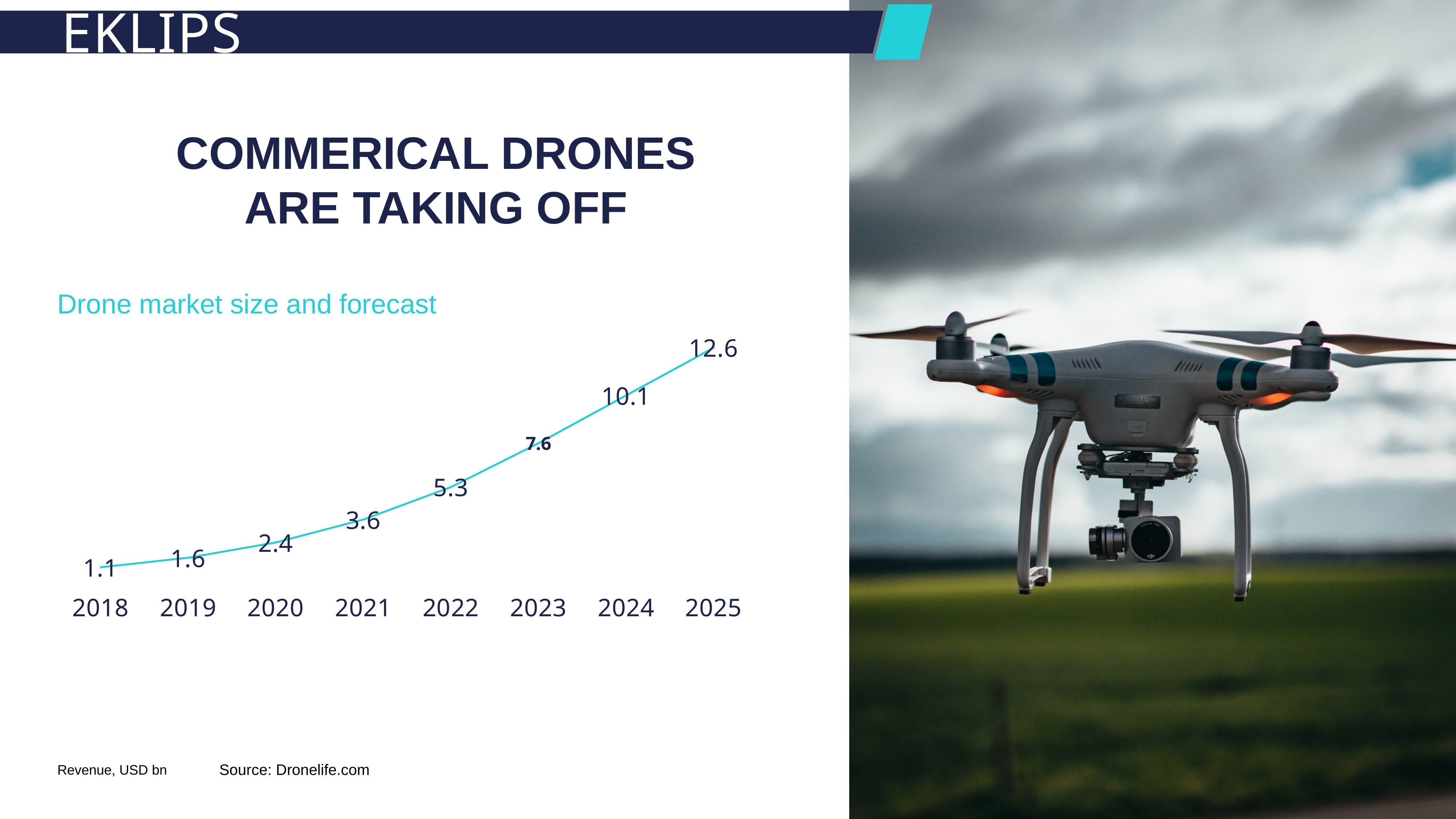
Which year has the highest value on the chart? 2025 Which year has the lowest value on the chart? 2018 What is the value shown for 2023? 7.6 Which is larger, the value for 2019 or the value for 2021? 2021 How many years are plotted on the chart? 8 What is the value shown for 2021? 3.6 What is the difference between the values for 2022 and 2020? 2.9 Do the values rise or fall from 2018 to 2025? rise What kind of chart is shown on the slide? line chart What is the difference between the values for 2025 and 2024? 2.5 What is the value shown for 2025? 12.6 What is the drone market size value shown for 2018? 1.1